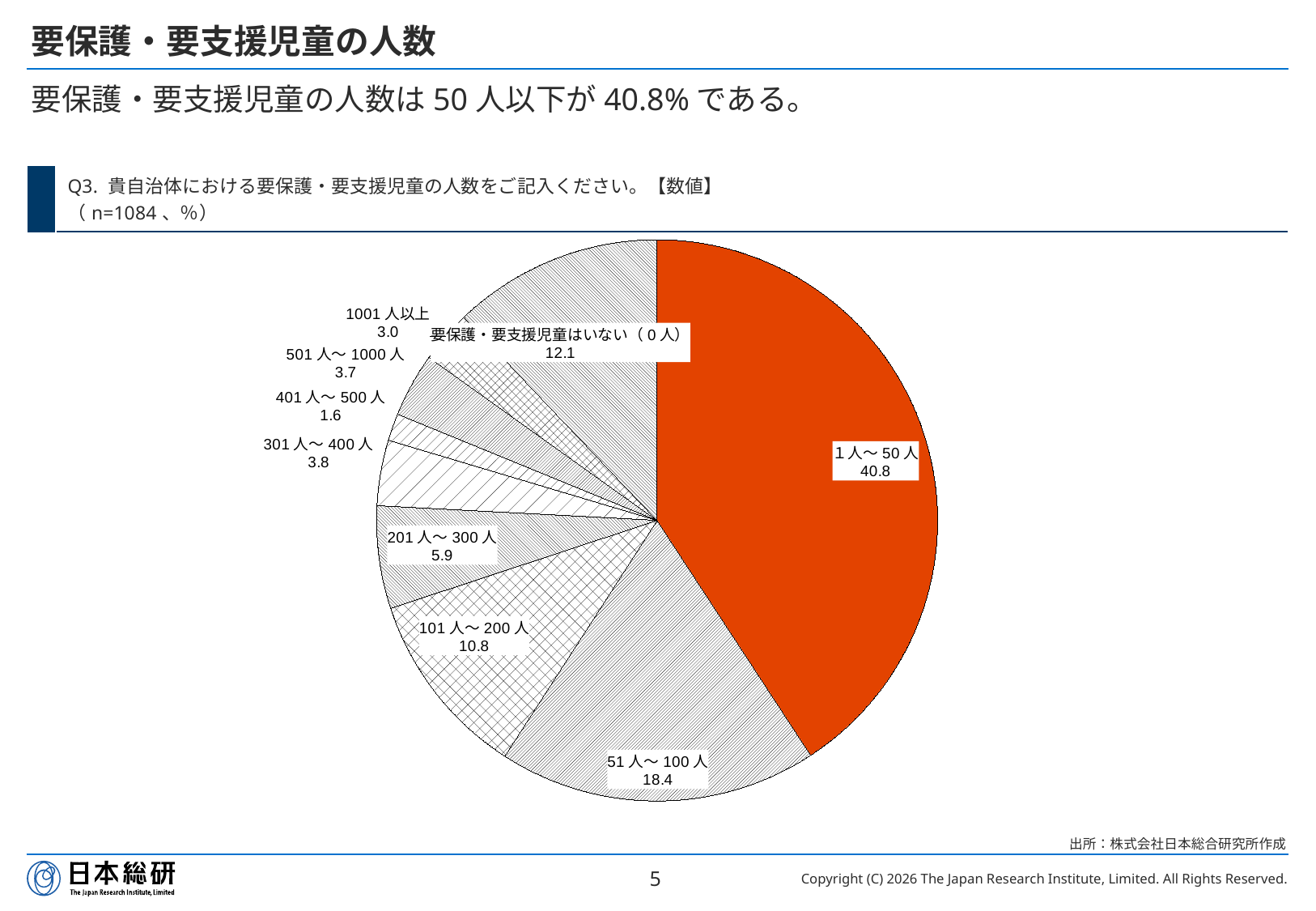
What is the sample size (n) stated for the chart? 1084 What is the value for 要保護・要支援児童はいない（0人）? 12.1 What is the value for 401人～500人? 1.6 What is the difference between the values for 1人～50人 and 51人～100人? 22.4 What is the value for 1人～50人? 40.8 Which is larger, the value for 101人～200人 or the value for 要保護・要支援児童はいない（0人）? 要保護・要支援児童はいない（0人） What kind of chart is shown on the slide? pie chart Which category has the largest share of the pie? 1人～50人 What is the value for 51人～100人? 18.4 Which category has the smallest share of the pie? 401人～500人 What is the difference between the values for 501人～1000人 and 1001人以上? 0.7 How many categories does the pie chart have? 9